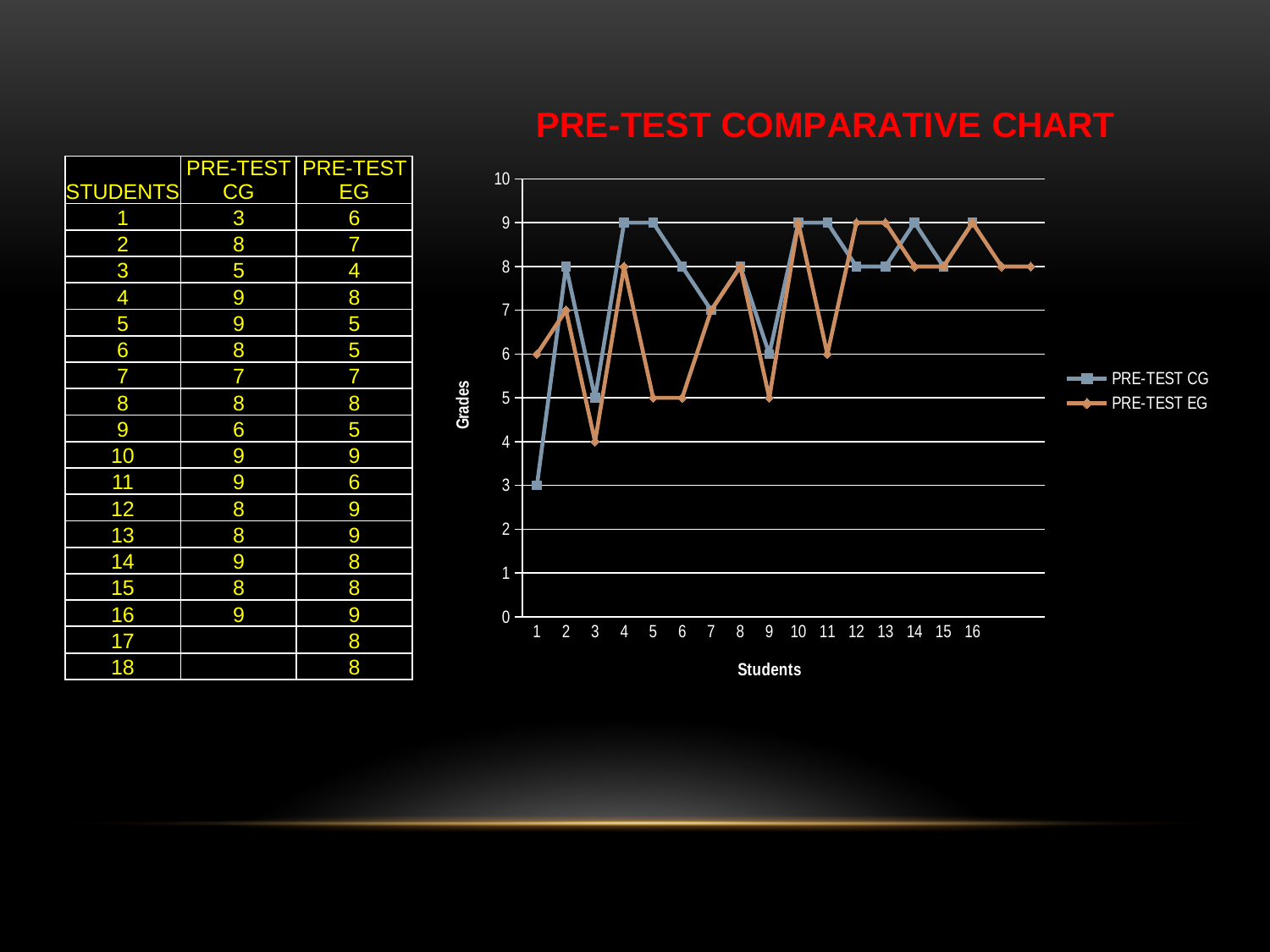
Which student has the lowest PRE-TEST CG grade? 1 Is the PRE-TEST CG grade for student 9 greater or less than 7? less What is the title of the chart? PRE-TEST COMPARATIVE CHART What is the difference between the PRE-TEST CG and PRE-TEST EG grades for student 5? 4 Which student has the lowest PRE-TEST EG grade? 3 What is the PRE-TEST CG grade for student 1? 3 What kind of chart is shown on the slide? line chart What is the label of the vertical axis of the chart? Grades What is the PRE-TEST EG grade for student 3? 4 How many series does the chart legend list? 2 For student 11, which series has the higher grade, PRE-TEST CG or PRE-TEST EG? PRE-TEST CG What is the highest grade reached by the PRE-TEST CG series? 9